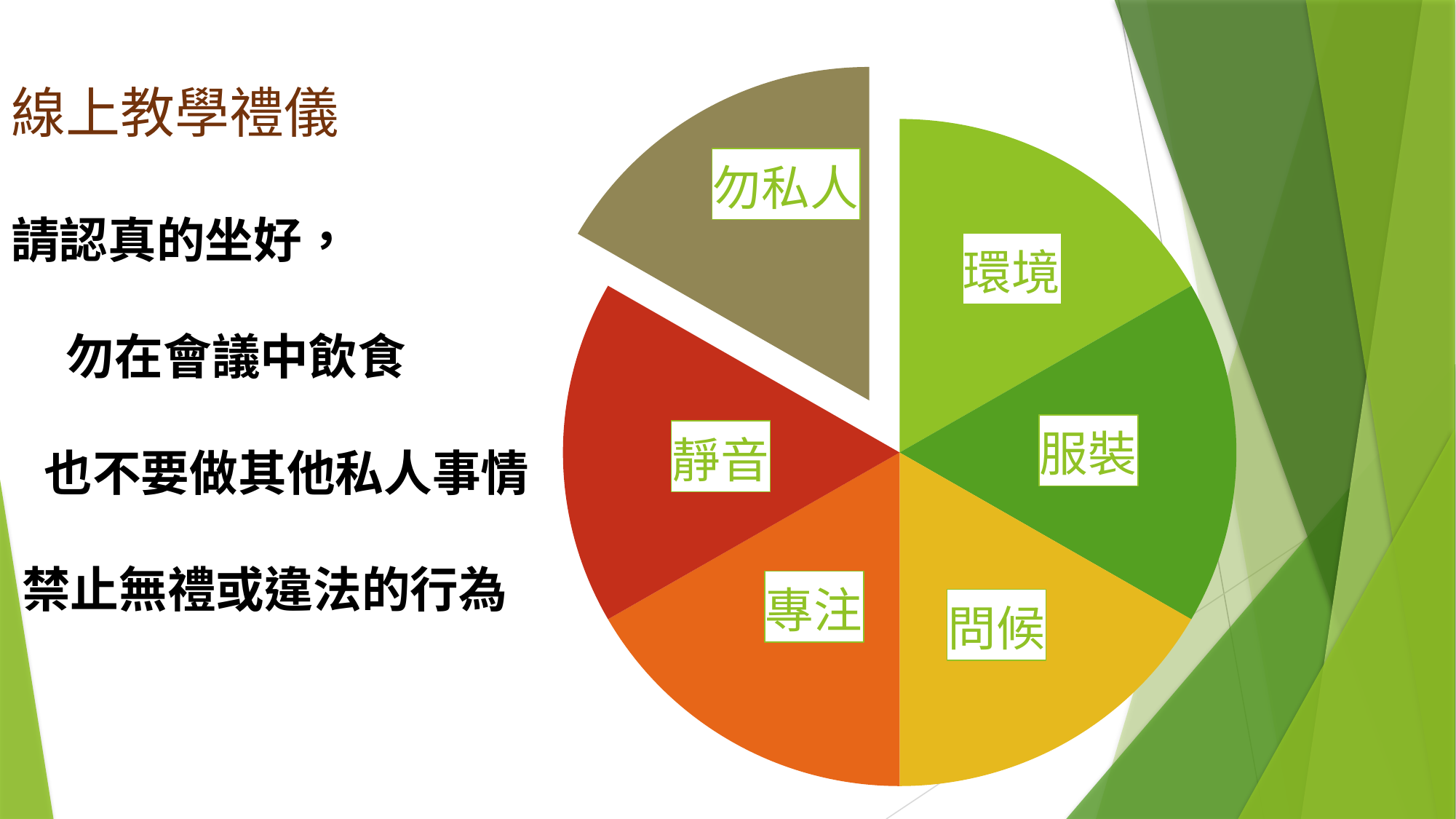
What colour is the slice labelled 靜音 in the pie chart? red Do the slices of the pie chart appear to be equal in size? yes How many slices does the pie chart have? 6 Which slice of the pie chart is pulled out (exploded) from the rest of the pie? 勿私人 What kind of chart is shown on the slide? pie chart